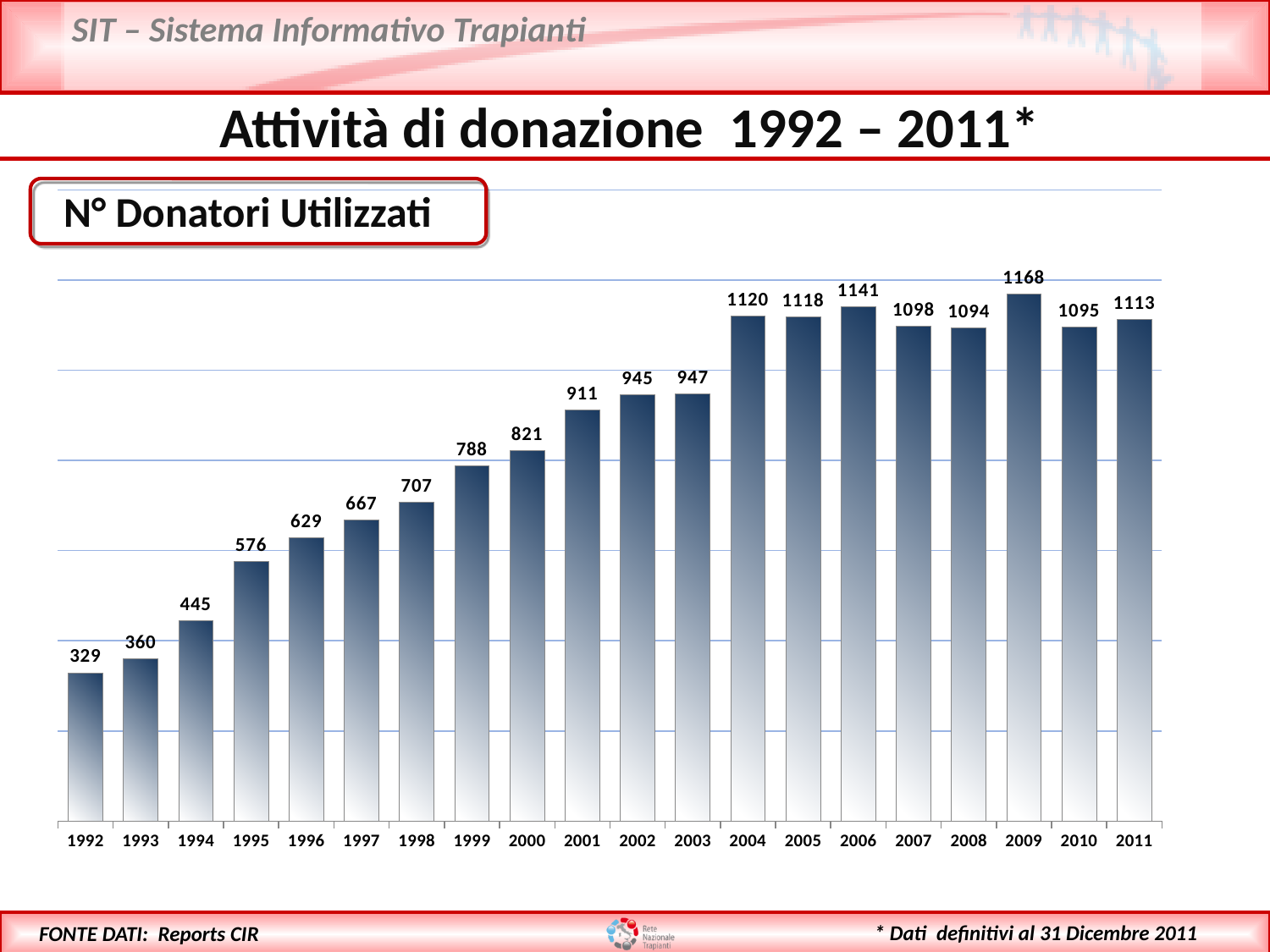
How many years are shown on the x axis? 20 What is the difference between the values for 2011 and 1992? 784 What kind of chart is shown on the slide? bar chart What is the number of donors used in 1992? 329 Which year has the highest number of donors used? 2009 What is the value shown for 2002? 945 Which year has the lowest number of donors used? 1992 What is the value shown for 2009? 1168 What is the title of the chart? N° Donatori Utilizzati Do the values generally rise or fall from 1992 to 2011? rise What is the difference between the values for 2004 and 2003? 173 Which is larger, the value for 2006 or the value for 2007? 2006